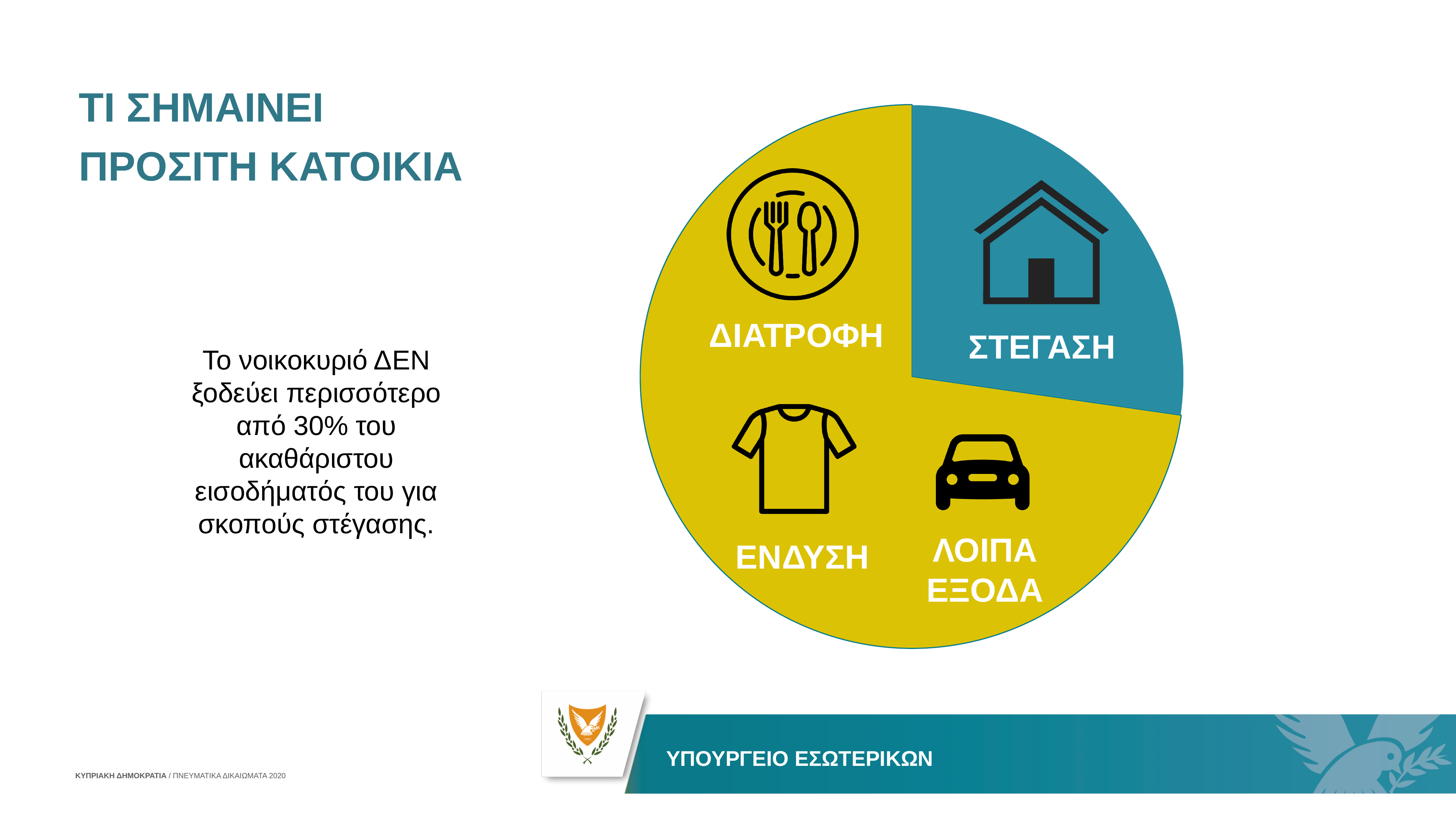
Which icon appears in the ΣΤΕΓΑΣΗ slice of the pie chart? A house Which category is shown in the blue slice of the pie chart? ΣΤΕΓΑΣΗ What kind of chart is shown on the slide? Pie chart Does the ΣΤΕΓΑΣΗ slice cover more or less than half of the pie chart? Less Which category occupies the smaller slice of the pie chart? ΣΤΕΓΑΣΗ How many category labels are written on the pie chart? 4 Which is larger in the pie chart: the blue ΣΤΕΓΑΣΗ slice or the yellow area? The yellow area